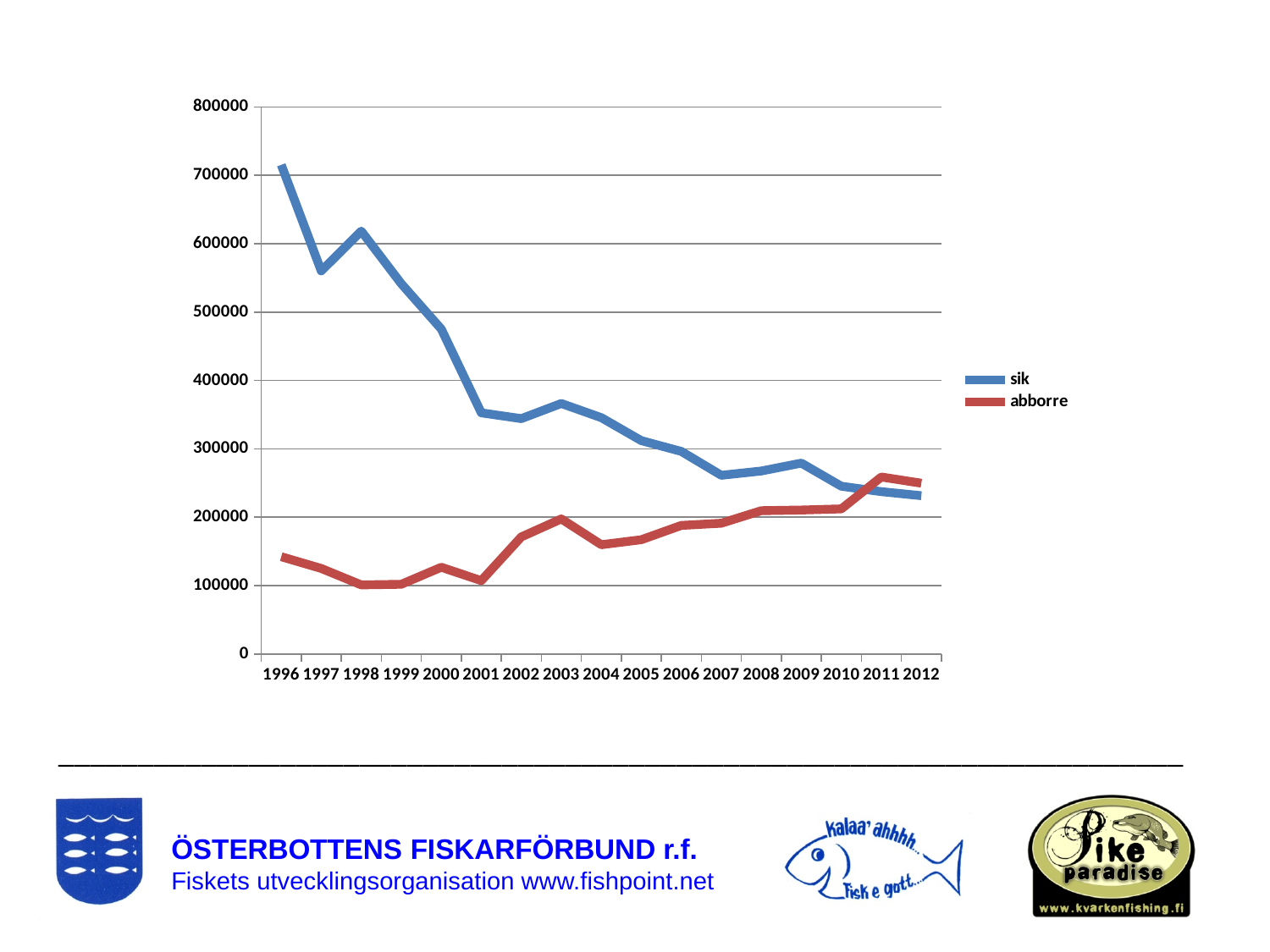
What kind of chart is shown on the slide? line chart Does the value for sik generally rise or fall from 1996 to 2012? fall Is the value for sik in 1996 greater or less than 600000? greater Which series has the larger value in 2012, sik or abborre? abborre Is the value for abborre in 1998 greater or less than 150000? less How many years are plotted along the x axis? 17 Is the value for abborre in 2003 greater or less than 150000? greater Which series has the larger value in 2005, sik or abborre? sik How many series does the legend list? 2 In which year is the value for sik highest? 1996 In which year is the value for abborre highest? 2011